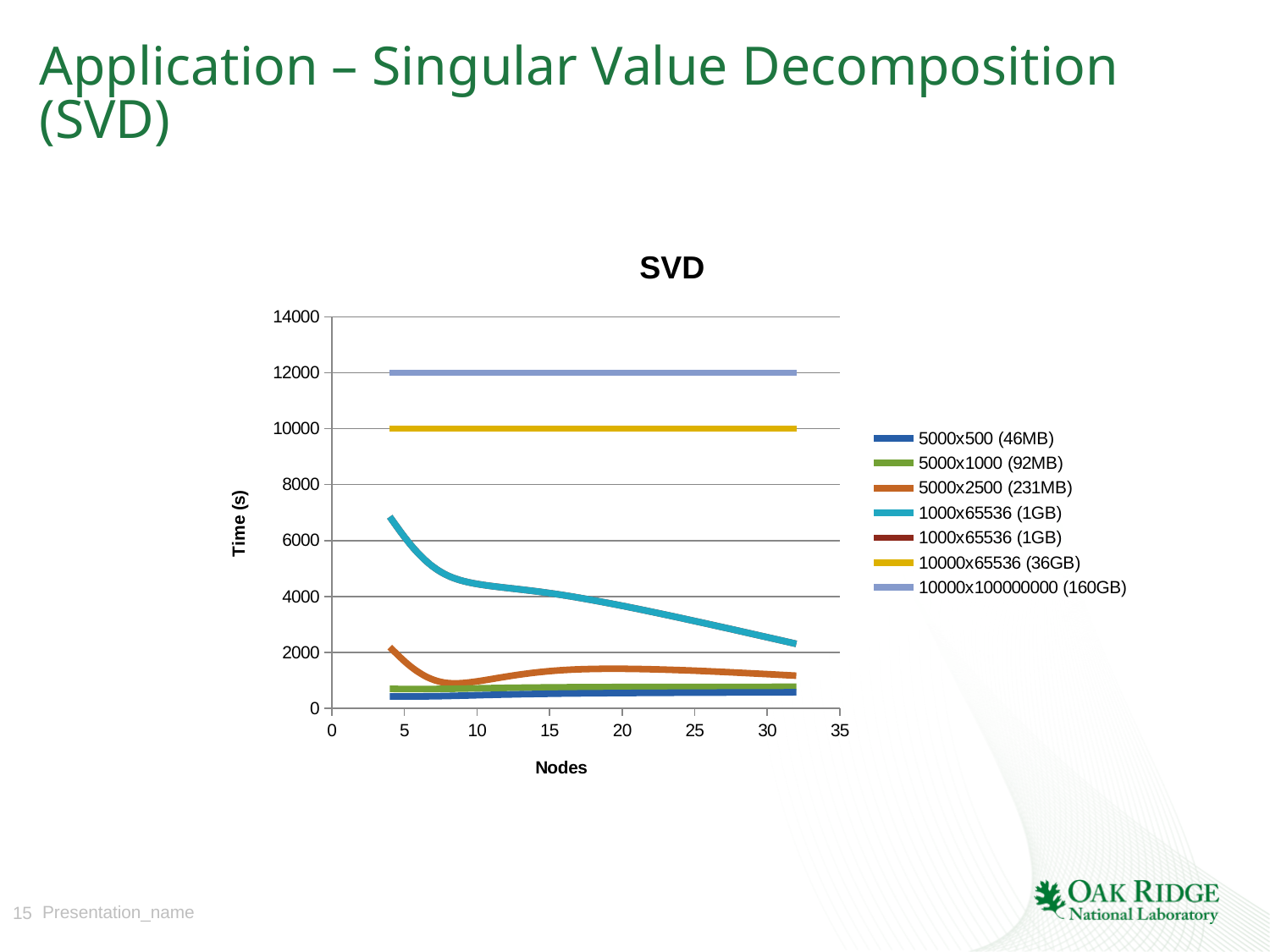
Is the time for the 5000x2500 (231MB) series at 10 nodes greater or less than 2000? less Does the time for the cyan 1000x65536 (1GB) series rise or fall as the number of nodes increases? fall Which series has the highest time in the SVD chart? 10000x100000000 (160GB) Which is larger in the SVD chart: the time for 10000x65536 (36GB) or for 10000x100000000 (160GB)? 10000x100000000 (160GB) What is the difference in time between the 10000x100000000 (160GB) series and the 10000x65536 (36GB) series in the SVD chart? 2000 What is the label of the x axis of the SVD chart? Nodes What is the time in seconds for the 10000x65536 (36GB) series in the SVD chart? 10000 How many series does the legend of the SVD chart list? 7 What is the time in seconds for the 10000x100000000 (160GB) series in the SVD chart? 12000 Which series has the lowest time in the SVD chart? 5000x500 (46MB) What kind of chart is shown on the slide? line chart